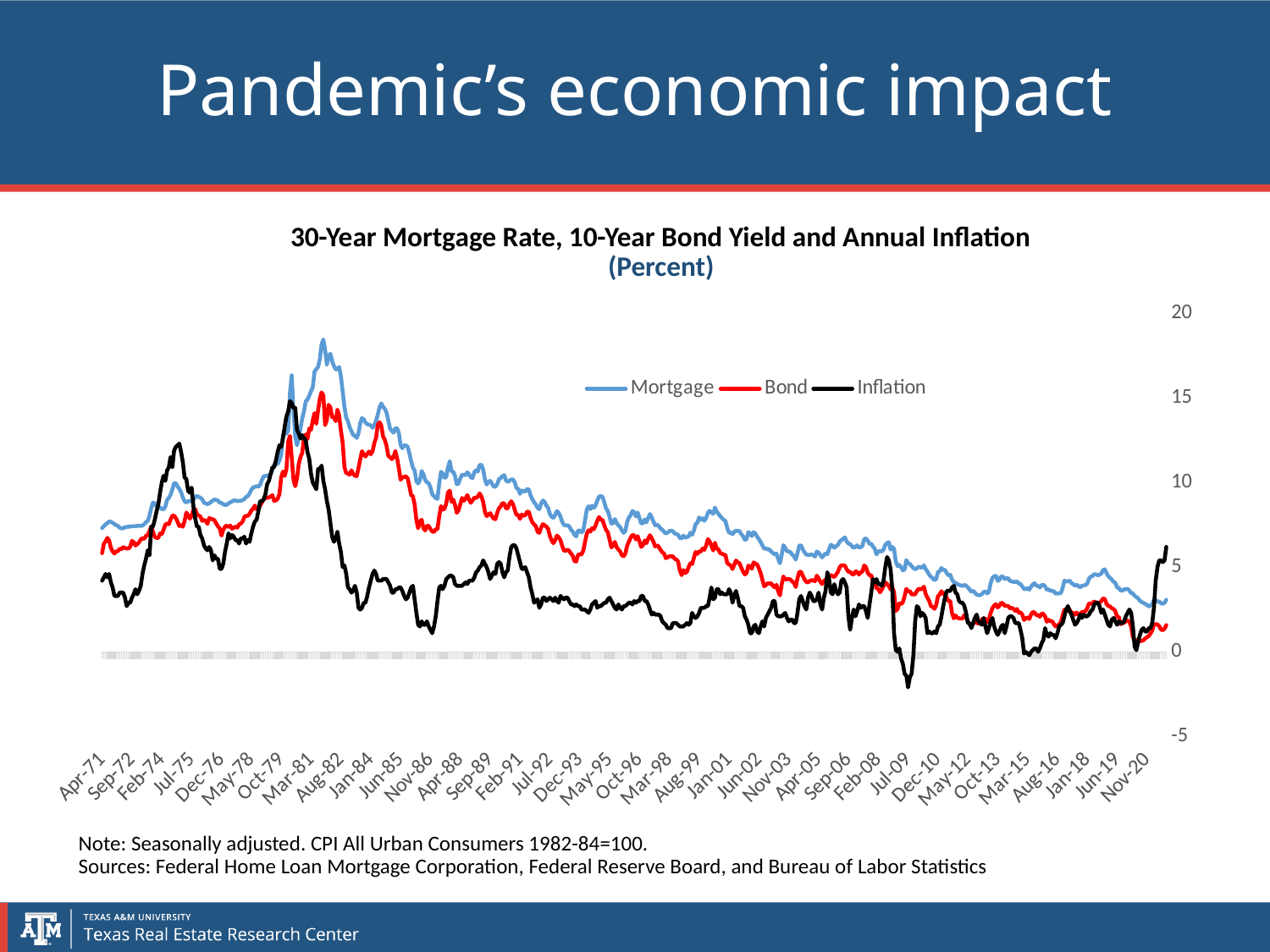
What is the title of the chart? 30-Year Mortgage Rate, 10-Year Bond Yield and Annual Inflation How many series does the chart's legend list? 3 What unit is the chart's data expressed in, according to the subtitle? Percent Which series reaches the highest value on the chart? Mortgage From its peak around Aug-82 to Nov-20, does the Mortgage series generally rise or fall? fall Around Aug-82, which is higher, the Mortgage series or the Inflation series? Mortgage Is the Mortgage value at Nov-20 greater or less than 5? less What kind of chart is shown on the slide? Line chart Is the lowest value of the Inflation series (around Jul-09) greater or less than 0? less Is the Bond value at Nov-20 greater or less than 5? less